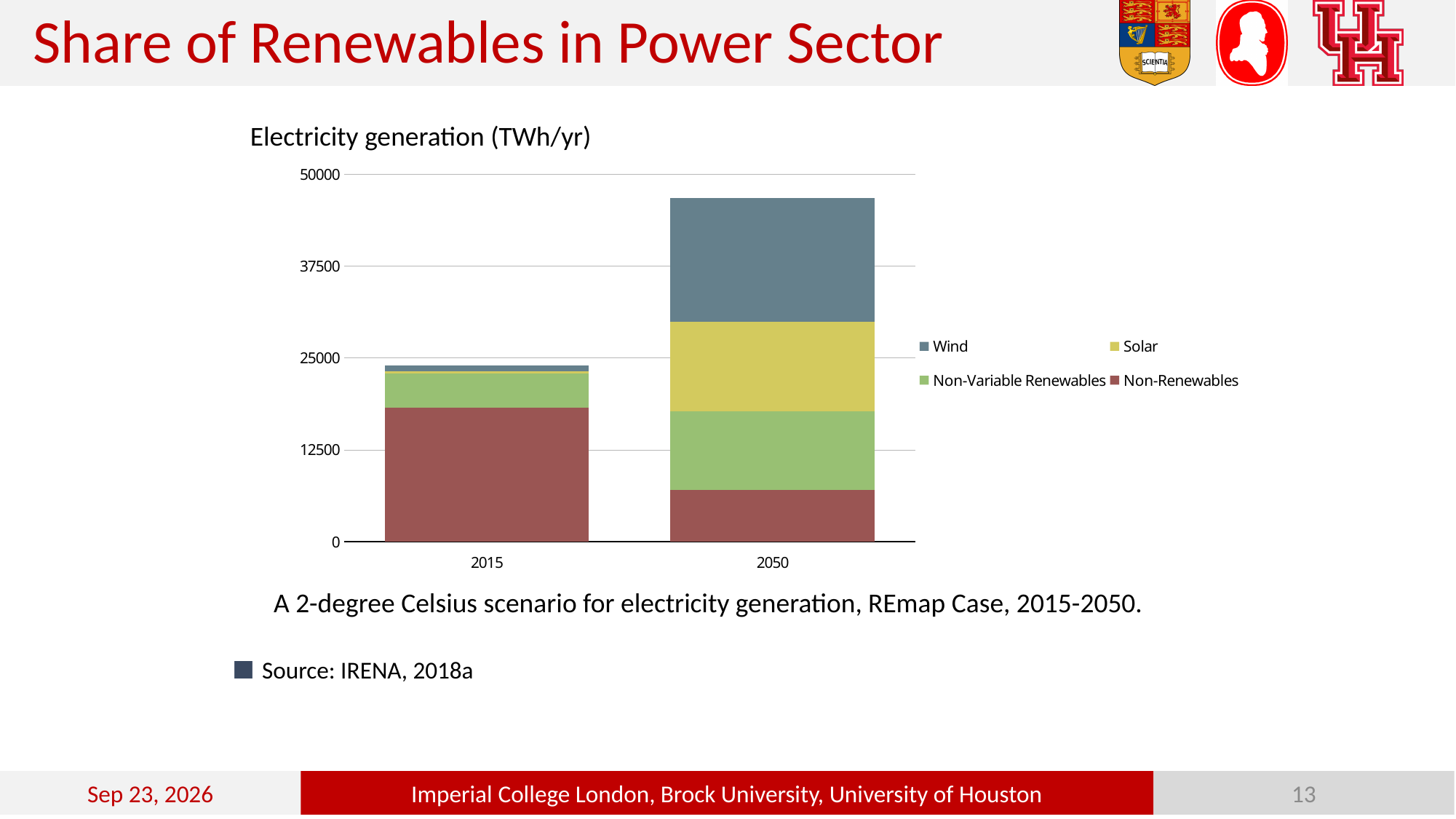
Is the Non-Renewables value for 2015 greater or less than 12500? greater What kind of chart is shown on the slide? Stacked bar chart Is the Non-Renewables value for 2050 greater or less than 12500? less How many categories (years) are shown on the x axis? 2 Is the total electricity generation for 2050 greater or less than 37500? greater Which series is plotted at the bottom of each stacked bar? Non-Renewables Does total electricity generation rise or fall from 2015 to 2050? rise Which year has the larger total electricity generation, 2015 or 2050? 2050 What is the title of the chart? Electricity generation (TWh/yr) How many series does the legend list? 4 Which year has the larger Non-Renewables value, 2015 or 2050? 2015